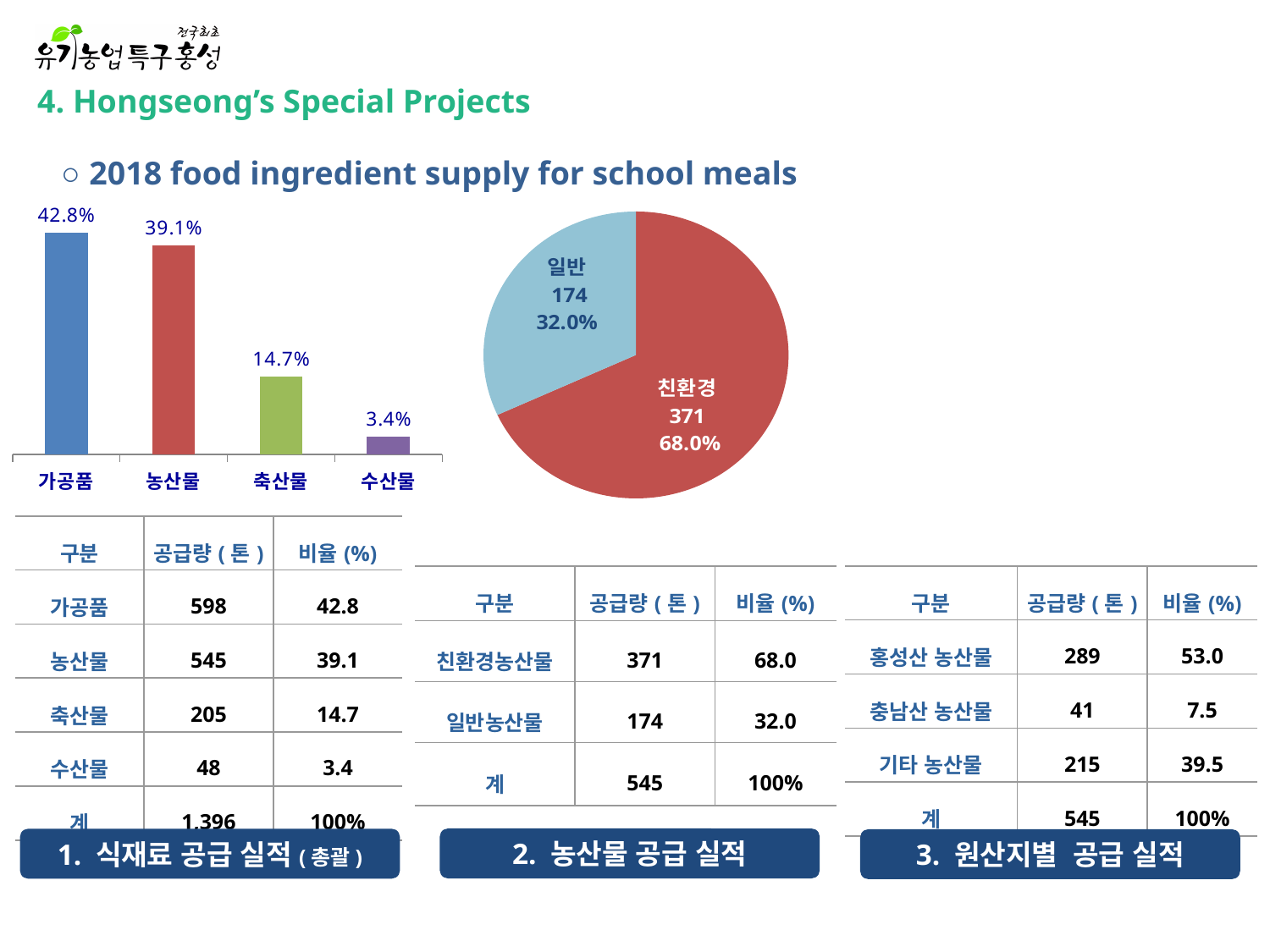
In the bar chart on the left, what is the value for 가공품? 42.8% In the bar chart on the left, which is larger, the value for 축산물 or the value for 수산물? 축산물 What kind of chart is the chart on the right of the slide? pie chart In the pie chart on the right, what share of the pie does 일반 represent? 32.0% In the bar chart on the left, which category has the highest value? 가공품 What kind of chart is the chart on the left of the slide? bar chart In the bar chart on the left, do the values rise or fall from left to right along the x axis? fall In the bar chart on the left, what is the difference between the values for 농산물 and 축산물? 24.4% In the bar chart on the left, which category has the lowest value? 수산물 How many categories are shown in the bar chart on the left? 4 In the pie chart on the right, what value is shown for 친환경? 371 In the bar chart on the left, what is the value for 축산물? 14.7%